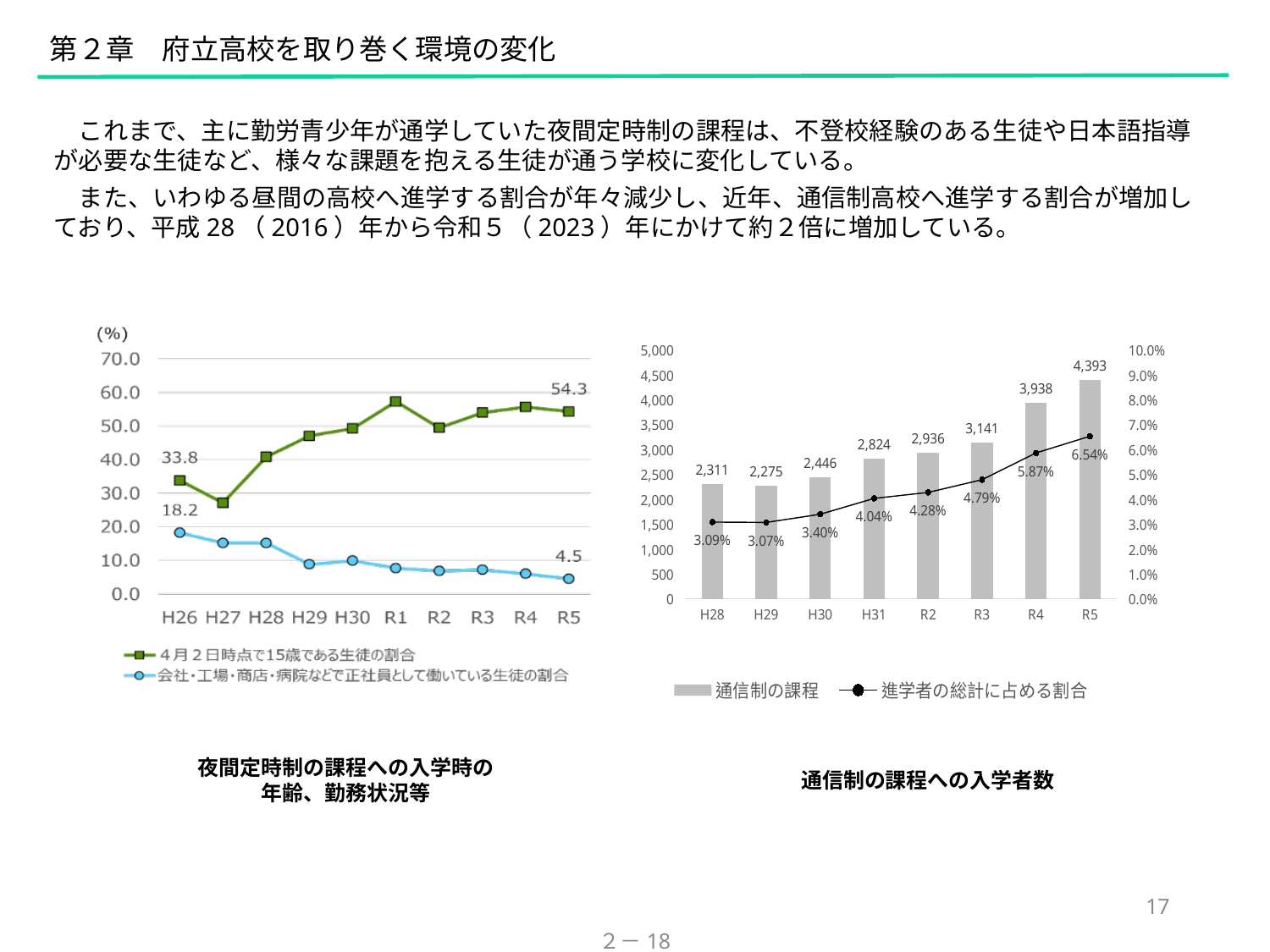
In the chart titled 通信制の課程への入学者数 (right), what is the value of 通信制の課程 for R5? 4,393 What kind of chart is the one titled 夜間定時制の課程への入学時の年齢、勤務状況等 (left)? line chart In the chart titled 通信制の課程への入学者数 (right), how many years are shown on the x axis? 8 In the chart titled 夜間定時制の課程への入学時の年齢、勤務状況等 (left), what is the value of 4月2日時点で15歳である生徒の割合 for R5? 54.3 In the chart titled 通信制の課程への入学者数 (right), how many series does the legend list? 2 In the chart titled 通信制の課程への入学者数 (right), which year has the lowest value of 通信制の課程? H29 In the chart titled 通信制の課程への入学者数 (right), what is the value of 進学者の総計に占める割合 for H31? 4.04% In the chart titled 通信制の課程への入学者数 (right), what is the difference between the 通信制の課程 values for R5 and H28? 2,082 In the chart titled 通信制の課程への入学者数 (right), does the 進学者の総計に占める割合 line generally rise or fall from H28 to R5? rise In the chart titled 夜間定時制の課程への入学時の年齢、勤務状況等 (left), what is the value of 会社・工場・商店・病院などで正社員として働いている生徒の割合 for H26? 18.2 In the chart titled 夜間定時制の課程への入学時の年齢、勤務状況等 (left), how many years are shown on the x axis? 10 In the chart titled 夜間定時制の課程への入学時の年齢、勤務状況等 (left), is the value of 4月2日時点で15歳である生徒の割合 for R1 greater or less than 50.0? greater